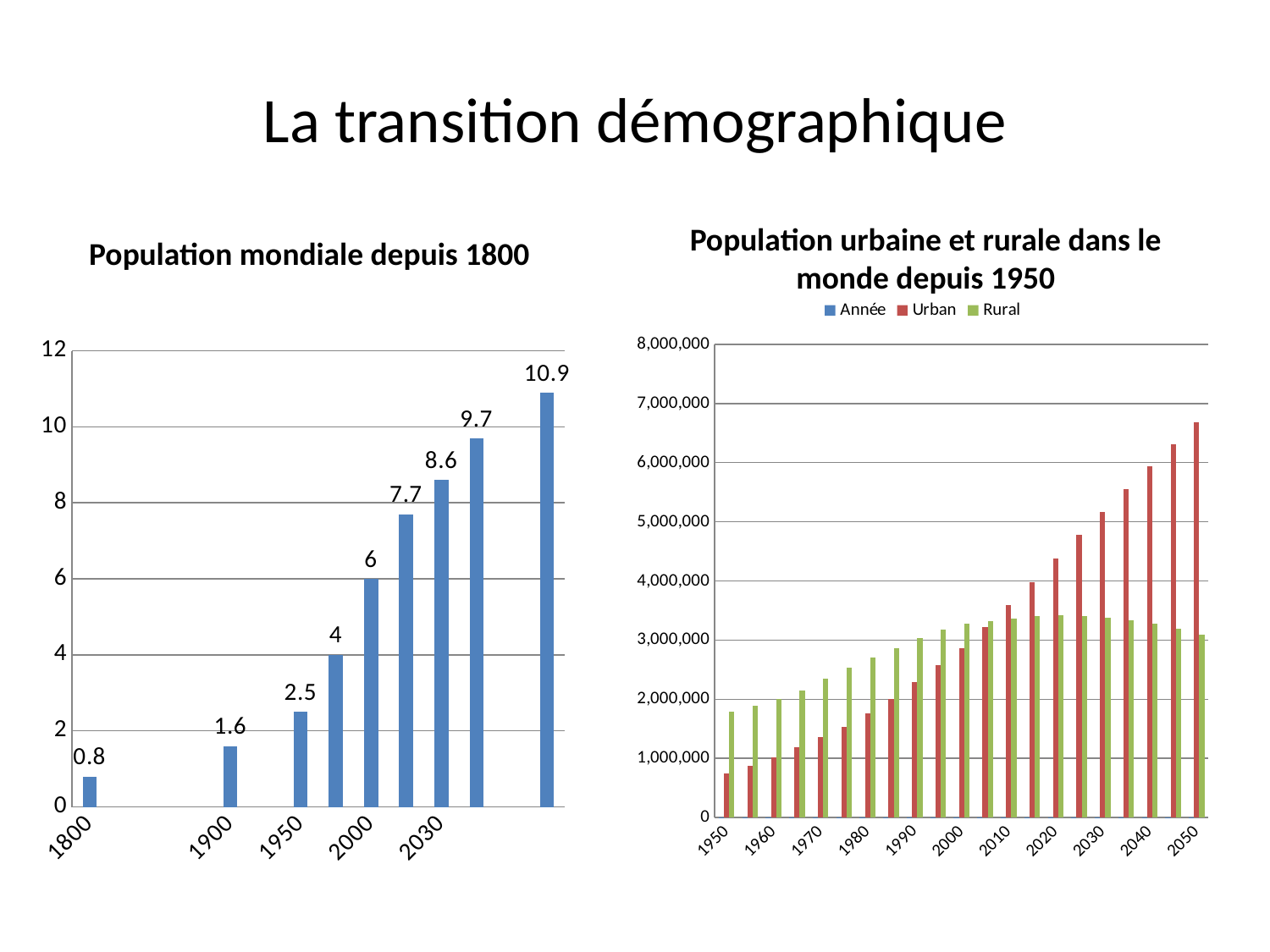
In the chart 'Population mondiale depuis 1800', what is the value for 1800? 0.8 What kind of chart is 'Population urbaine et rurale dans le monde depuis 1950'? bar chart In the chart 'Population mondiale depuis 1800', what is the difference between the highest value (10.9) and the lowest value (0.8)? 10.1 In the chart 'Population mondiale depuis 1800', do the values rise or fall from left to right? rise In the chart 'Population mondiale depuis 1800', what is the value of the shortest bar? 0.8 In the chart 'Population urbaine et rurale dans le monde depuis 1950', which is larger in 1950, Urban or Rural? Rural How many entries does the legend of the chart 'Population urbaine et rurale dans le monde depuis 1950' list? 3 In the chart 'Population mondiale depuis 1800', how many bars are plotted? 9 In the chart 'Population mondiale depuis 1800', what is the value for 1900? 1.6 In the chart 'Population urbaine et rurale dans le monde depuis 1950', is the Urban value for 2050 greater or less than 6,000,000? greater In the chart 'Population mondiale depuis 1800', what is the value of the tallest bar? 10.9 In the chart 'Population urbaine et rurale dans le monde depuis 1950', in which year is the Urban value highest? 2050